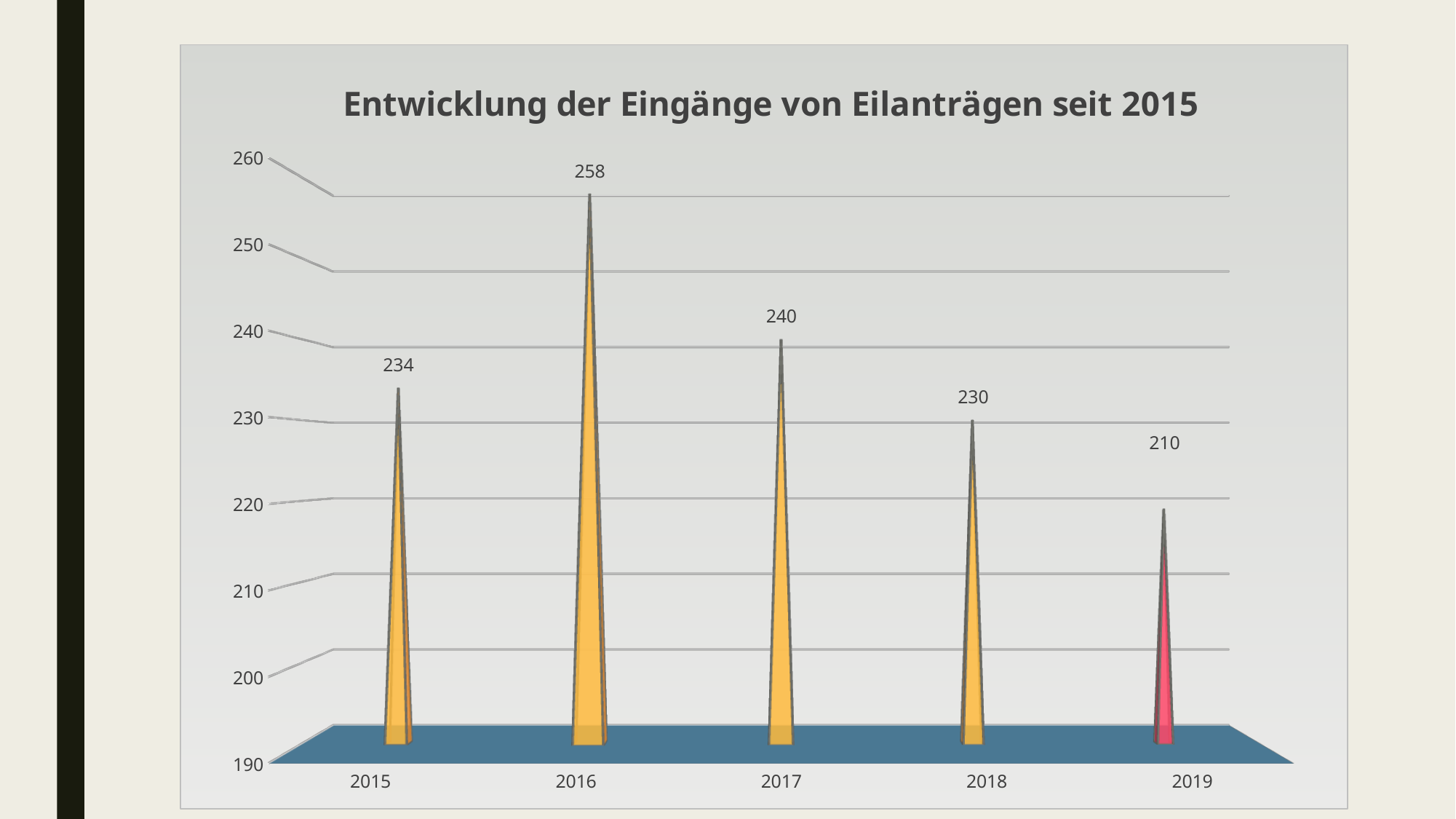
Which year has the highest value? 2016 What is the value for 2019? 210 What is the title of the chart? Entwicklung der Eingänge von Eilanträgen seit 2015 Which year has the lowest value? 2019 Do the values rise or fall from 2016 to 2019? fall What is the value for 2017? 240 How many years are shown on the x axis? 5 What is the value for 2016? 258 Which is larger, the value for 2015 or the value for 2017? 2017 What kind of chart is this? bar chart What is the difference between the values for 2015 and 2018? 4 What is the difference between the values for 2016 and 2019? 48